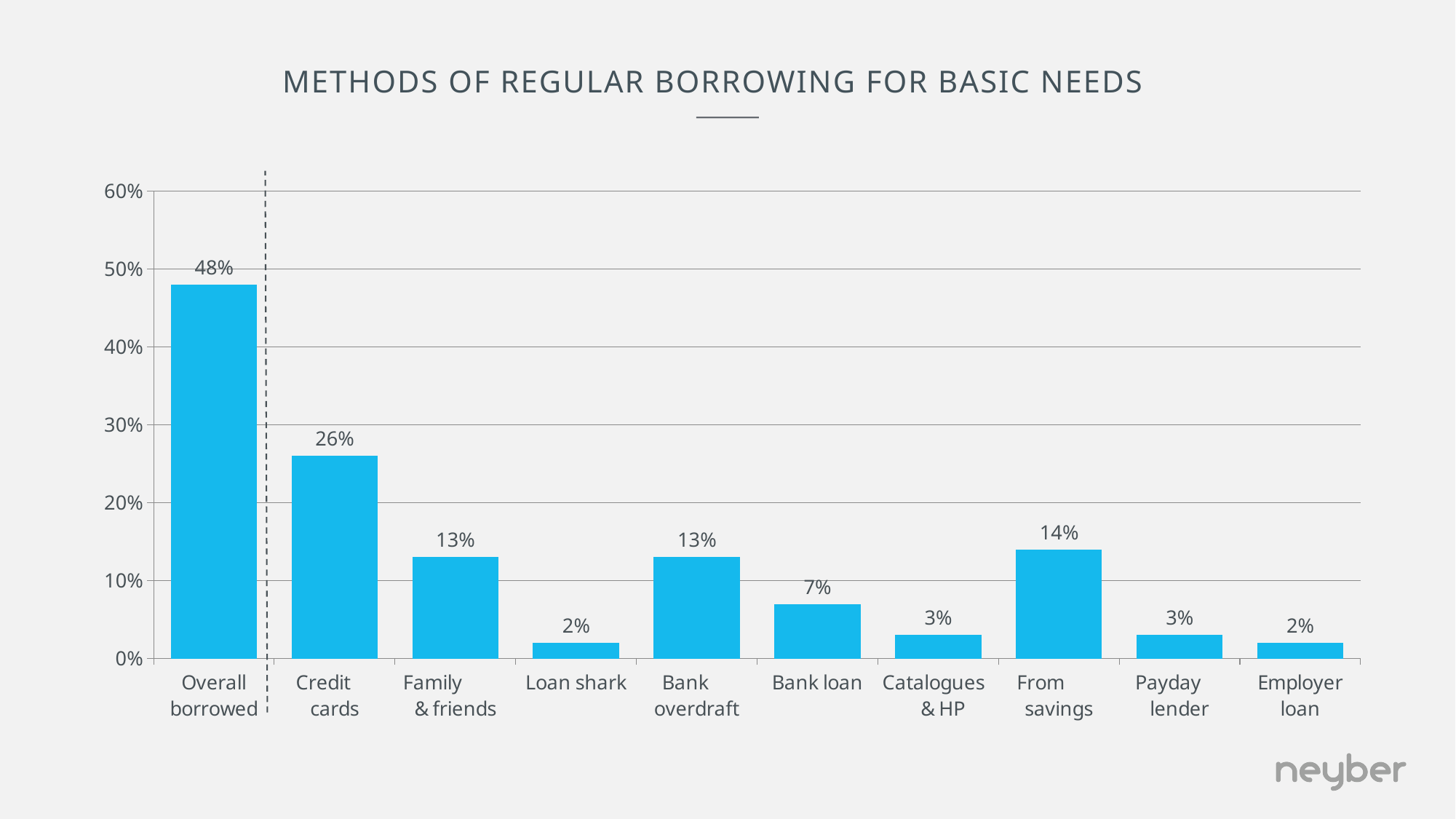
What kind of chart is this? bar chart What is the value for Overall borrowed? 48% What is the value for From savings? 14% What is the difference between Credit cards and From savings? 12% Is the value for Credit cards greater or less than 20%? greater Excluding Overall borrowed, which borrowing method has the highest value? Credit cards What is the title of the chart? METHODS OF REGULAR BORROWING FOR BASIC NEEDS Which is larger, Bank loan or Catalogues & HP? Bank loan How many categories are shown on the x axis? 10 What is the value for Bank loan? 7% Which category has the highest value? Overall borrowed What is the value for Credit cards? 26%